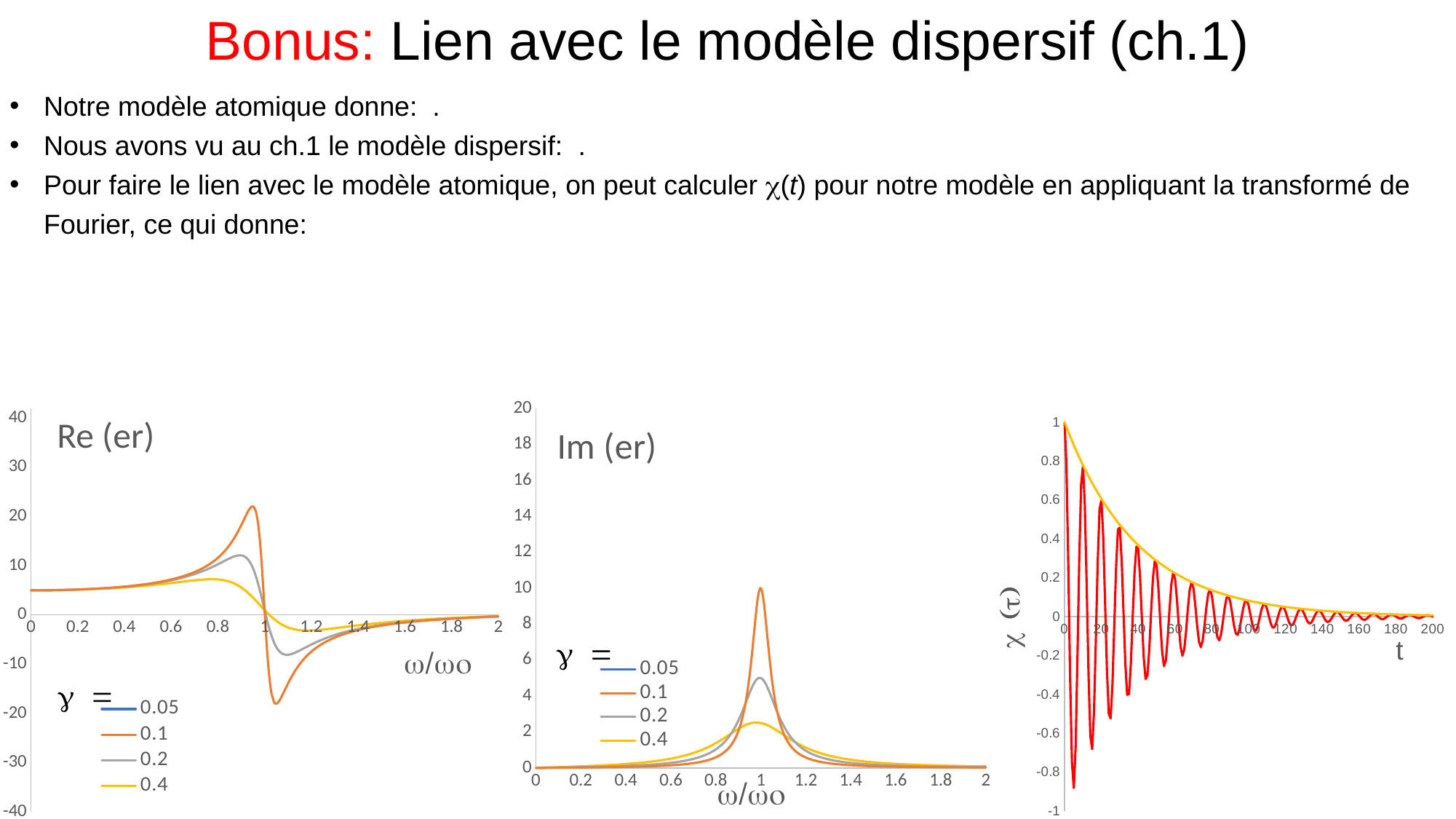
In the χ(τ) chart on the right, does the amplitude of the oscillation rise or fall as t increases? fall In the Im (er) chart, is the peak of the γ = 0.1 curve greater or less than 8? greater In the Im (er) chart, is the peak of the γ = 0.4 curve greater or less than 4? less What is the label of the x axis of the χ(τ) chart on the right? t In the Im (er) chart, at which value of ω/ω0 do the curves reach their peak? 1 In the Im (er) chart, which γ value has the highest peak? 0.1 What kind of chart is the Re (er) chart on the left? line chart In the Re (er) chart, is the minimum value of the γ = 0.1 curve greater or less than -10? less What values of γ are listed in the legend of the Im (er) chart? 0.05, 0.1, 0.2, 0.4 In the χ(τ) chart on the right, what is the value of the curve at t = 0? 1 How many series does the legend of the Re (er) chart list? 4